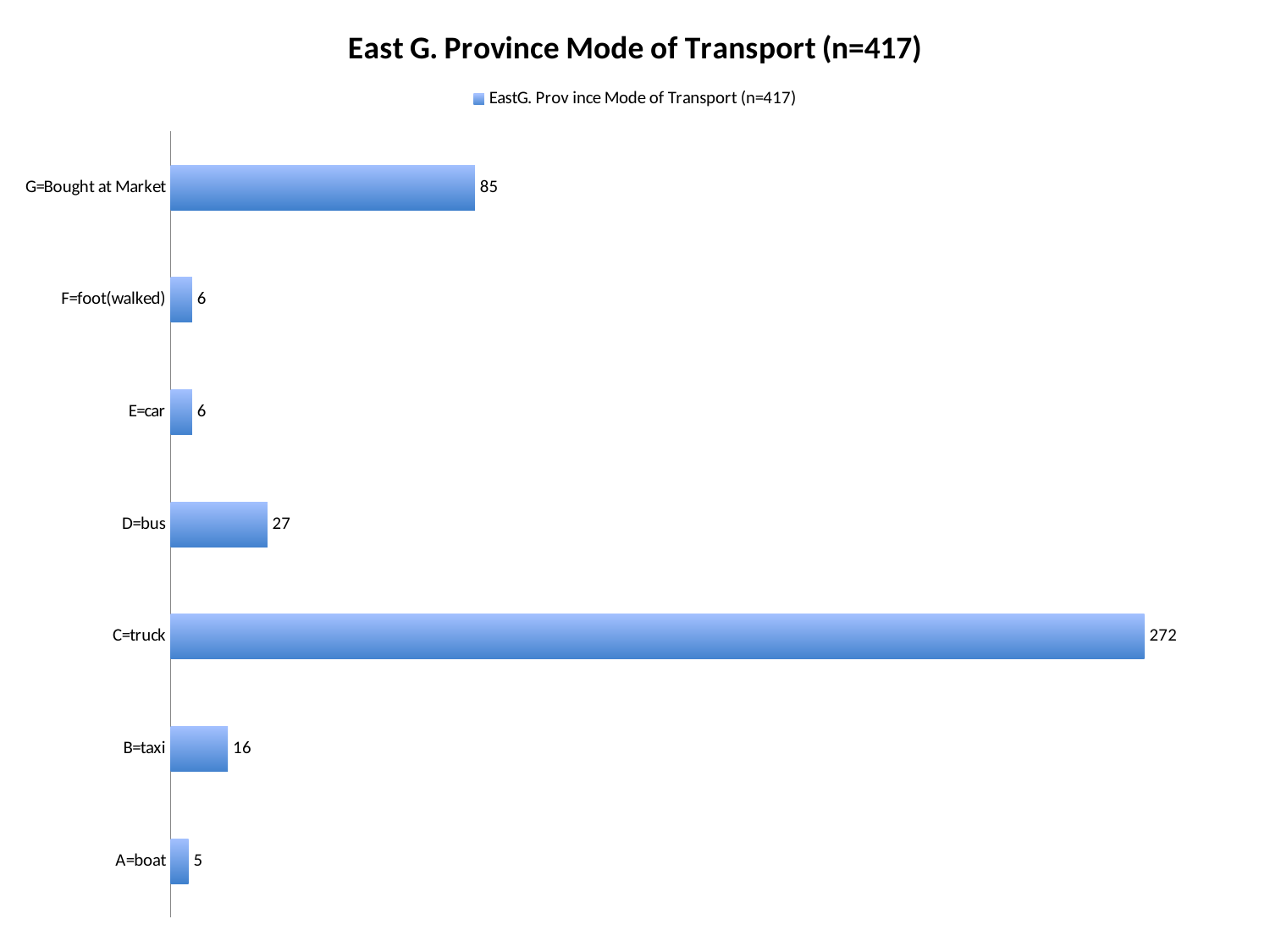
What is the difference between the values for C=truck and G=Bought at Market? 187 What is the value for B=taxi? 16 What is the value for D=bus? 27 What is the value for C=truck? 272 How many categories are shown in the chart? 7 Which category has the highest value? C=truck What is the title of the chart? East G. Province Mode of Transport (n=417) What kind of chart is shown on the slide? bar chart How many series does the legend list? 1 What is the value for G=Bought at Market? 85 Which is larger, the value for D=bus or the value for B=taxi? D=bus Which category has the lowest value? A=boat